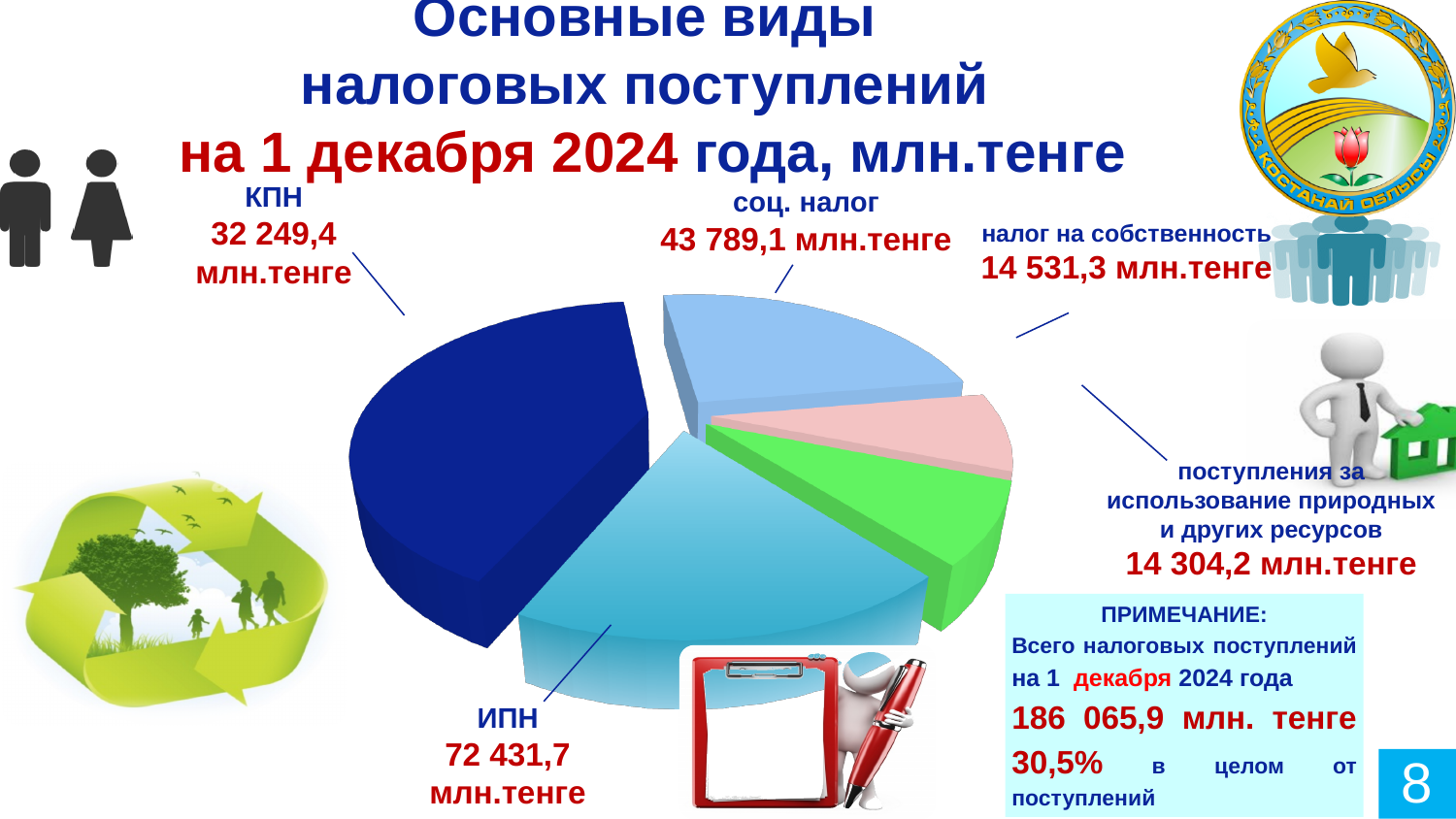
What is the value for налог на собственность? 14 531,3 млн.тенге Which category has the highest value in the pie chart? ИПН What is the value for поступления за использование природных и других ресурсов? 14 304,2 млн.тенге What is the difference between the values for ИПН and соц. налог? 28 642,6 млн.тенге What kind of chart is shown on the slide? pie chart What is the value for соц. налог? 43 789,1 млн.тенге Which is larger, налог на собственность or поступления за использование природных и других ресурсов? налог на собственность Which category has the lowest value in the pie chart? поступления за использование природных и других ресурсов What is the value for ИПН? 72 431,7 млн.тенге How many slices does the pie chart have? 5 What is the value for КПН? 32 249,4 млн.тенге What is the difference between the values for соц. налог and КПН? 11 539,7 млн.тенге